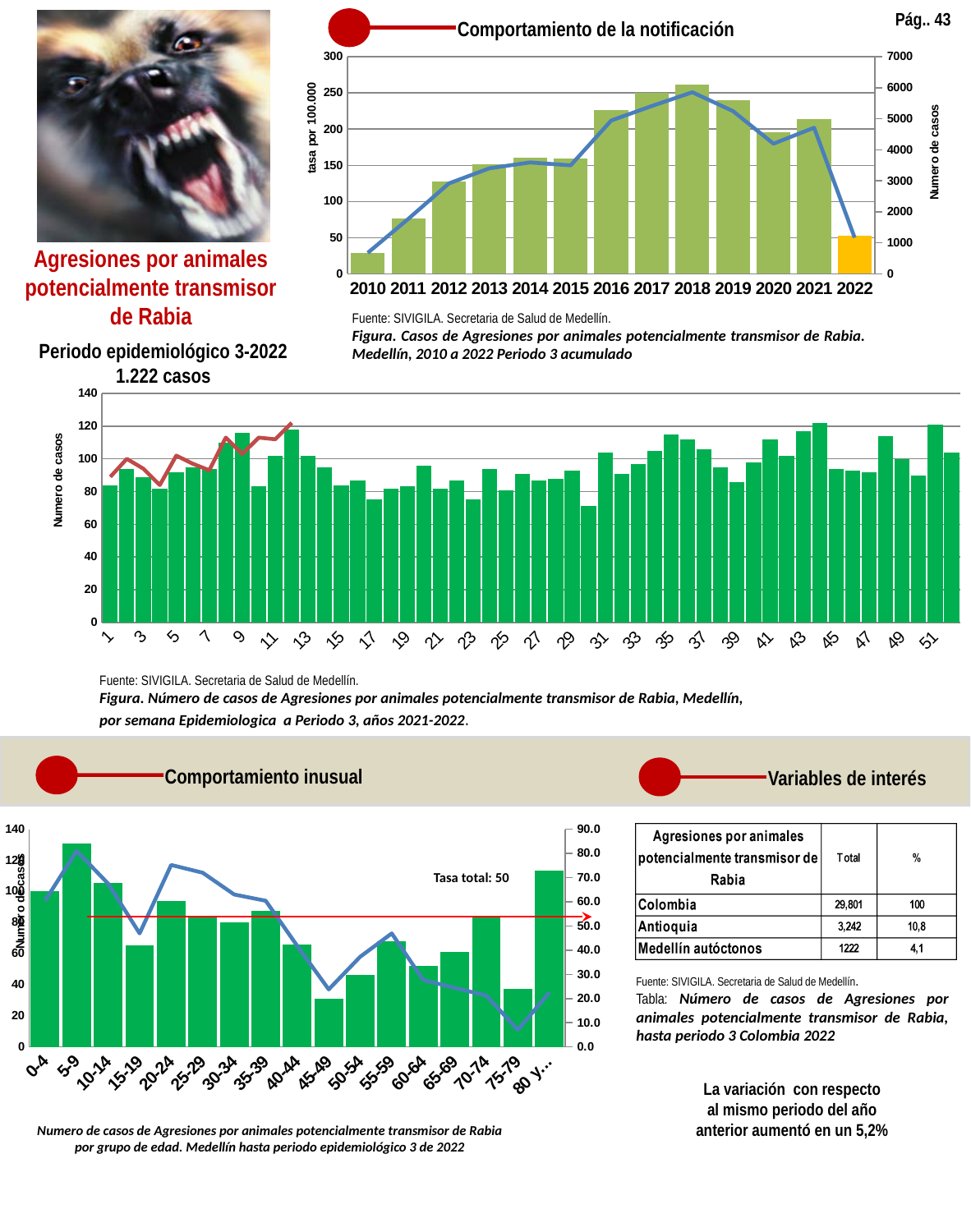
In the top-right chart (Comportamiento de la notificación), what colour is the bar for 2022? Orange In the top-right chart (Comportamiento de la notificación), is the bar for 2018 greater or less than 5000 on the right axis (Numero de casos)? greater In the top-right chart (Comportamiento de la notificación), which year has the shortest bar? 2010 In the bottom-left chart by age group, which age group has the shortest bar? 75-79 In the top-right chart (Comportamiento de la notificación), do the bars rise or fall from 2010 to 2018? rise In the top-right chart (Comportamiento de la notificación), is the line value for 2022 greater or less than 100 on the left axis (tasa por 100.000)? less In the middle chart of weekly cases (Numero de casos by semana), is the bar for week 30 greater or less than 80? less In the top-right chart (Comportamiento de la notificación), which year has the tallest bar? 2018 In the bottom-left chart by age group, how many age groups are shown on the x axis? 17 In the bottom-left chart by age group, what is the 'Tasa total' value printed on the chart? 50 In the bottom-left chart by age group, which age group has the tallest bar? 5-9 In the top-right chart (Comportamiento de la notificación), how many years are shown on the x axis? 13